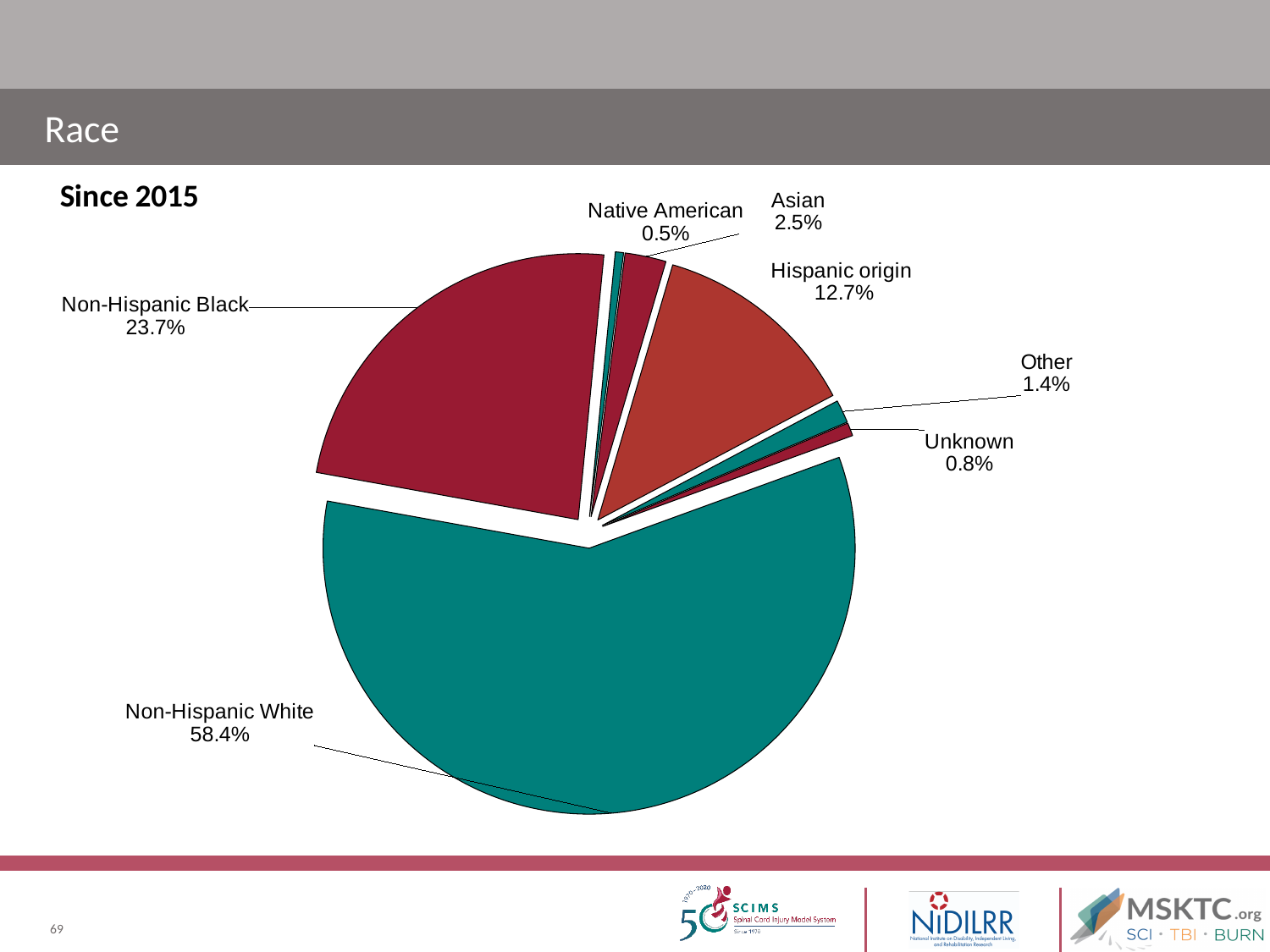
Which is larger, the share for Asian or the share for Other? Asian What percentage of the pie is Non-Hispanic White? 58.4% What is the value for Native American? 0.5% What kind of chart is shown on the slide? pie chart How many categories are shown in the pie chart? 7 Which race category has the smallest share of the pie? Native American What is the difference between the Non-Hispanic White and Non-Hispanic Black shares? 34.7% What percentage is shown for Hispanic origin? 12.7% What time period label appears above the pie chart? Since 2015 What is the difference between the Hispanic origin and Asian shares? 10.2% What is the value for Unknown? 0.8% Which race category has the largest share of the pie? Non-Hispanic White